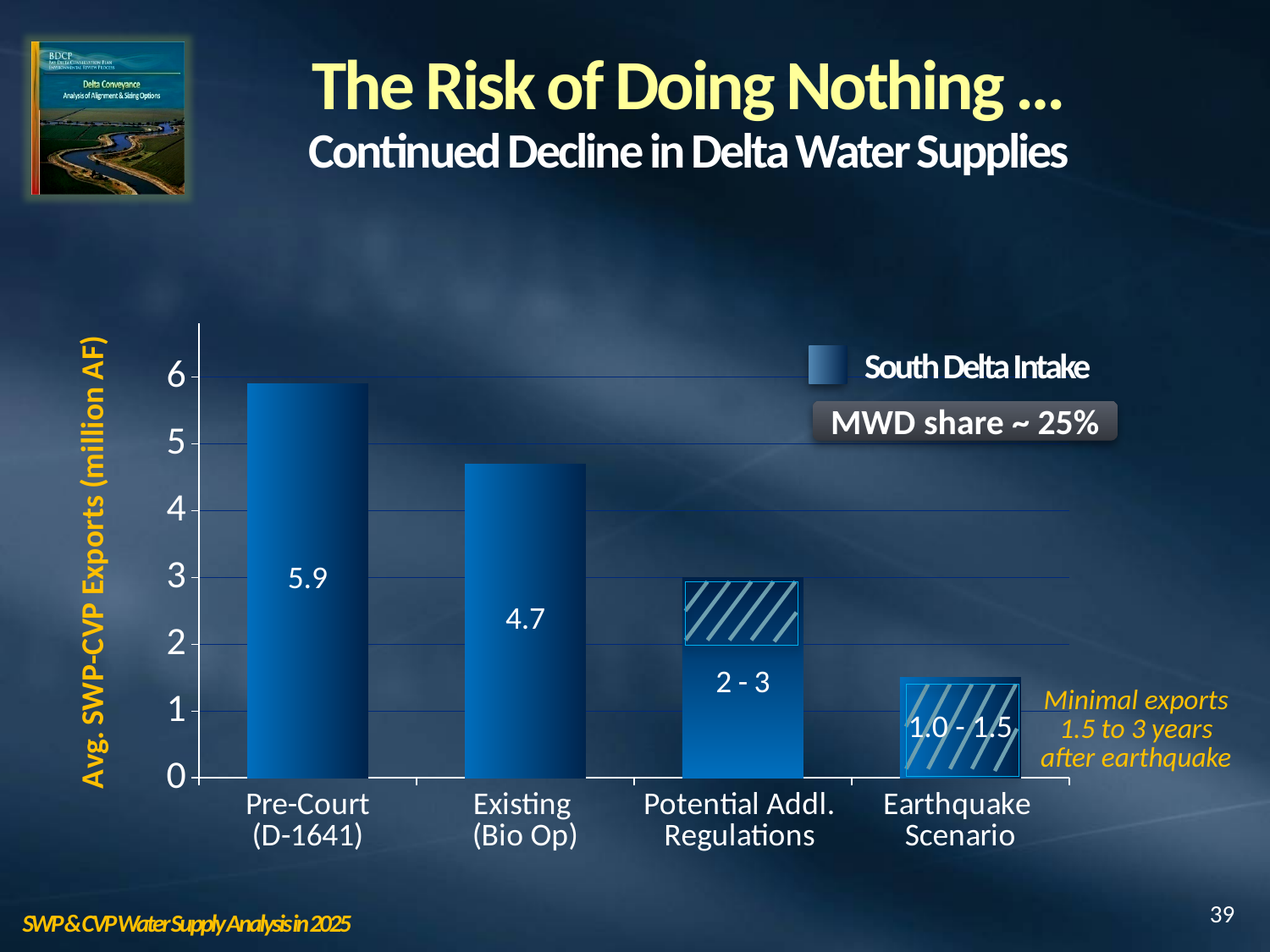
Which is larger, the value for Existing (Bio Op) or the value for Potential Addl. Regulations? Existing (Bio Op) What is the value for Pre-Court (D-1641)? 5.9 What kind of chart is shown on the slide? bar chart What value is labelled on the Earthquake Scenario bar? 1.0 - 1.5 What is the difference between the Pre-Court (D-1641) value and the Existing (Bio Op) value? 1.2 Which category has the highest value? Pre-Court (D-1641) What is the value for Existing (Bio Op)? 4.7 Is the value for Existing (Bio Op) greater or less than 4? greater Which category has the lowest value? Earthquake Scenario Do the values rise or fall from left to right along the x axis? fall How many categories are shown on the x axis? 4 What value is labelled on the Potential Addl. Regulations bar? 2 - 3